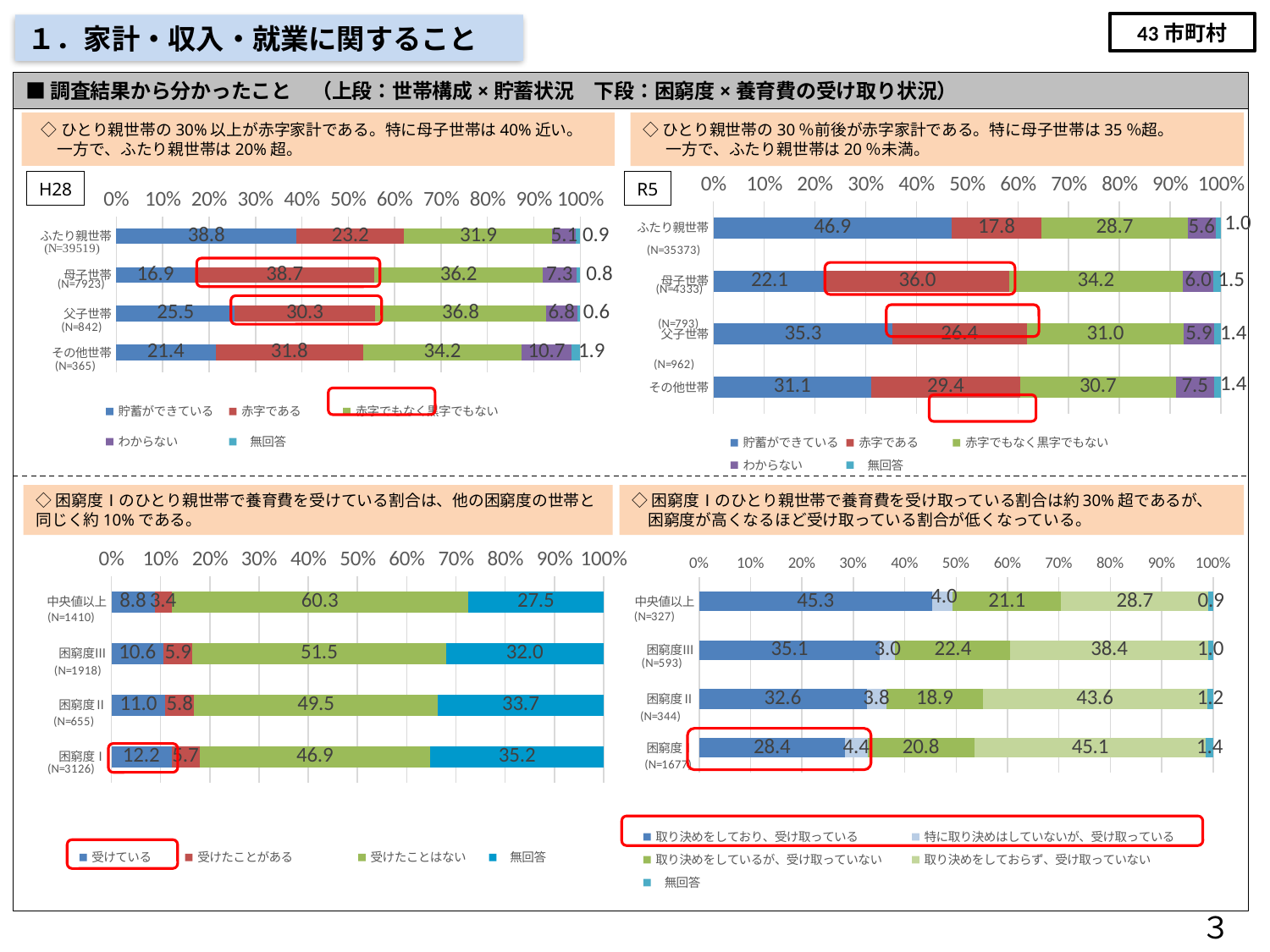
How many household categories are shown in the top-left chart (H28)? 4 In the top-right chart (R5), which household type has the lowest value for 貯蓄ができている? 母子世帯 In the bottom-left chart (H28), what is the value of 受けている for 困窮度Ⅰ? 12.2 What kind of chart is the bottom-right chart (R5)? Stacked horizontal bar chart In the bottom-right chart (R5), which category has the highest value for 取り決めをしており、受け取っている? 中央値以上 In the top-right chart (R5), what is the difference between the 赤字である values for 母子世帯 and ふたり親世帯? 18.2 In the top-left chart (H28), what is the value of 赤字である for 母子世帯? 38.7 How many series does the legend of the bottom-left chart (H28) list? 4 In the bottom-left chart (H28), which is larger, the 受けたことはない value for 中央値以上 or for 困窮度Ⅰ? 中央値以上 In the top-right chart (R5), what is the value of 貯蓄ができている for ふたり親世帯? 46.9 In the top-left chart (H28), which household type has the highest value for 赤字である? 母子世帯 In the bottom-right chart (R5), what is the value of 取り決めをしており、受け取っている for 困窮度Ⅰ? 28.4